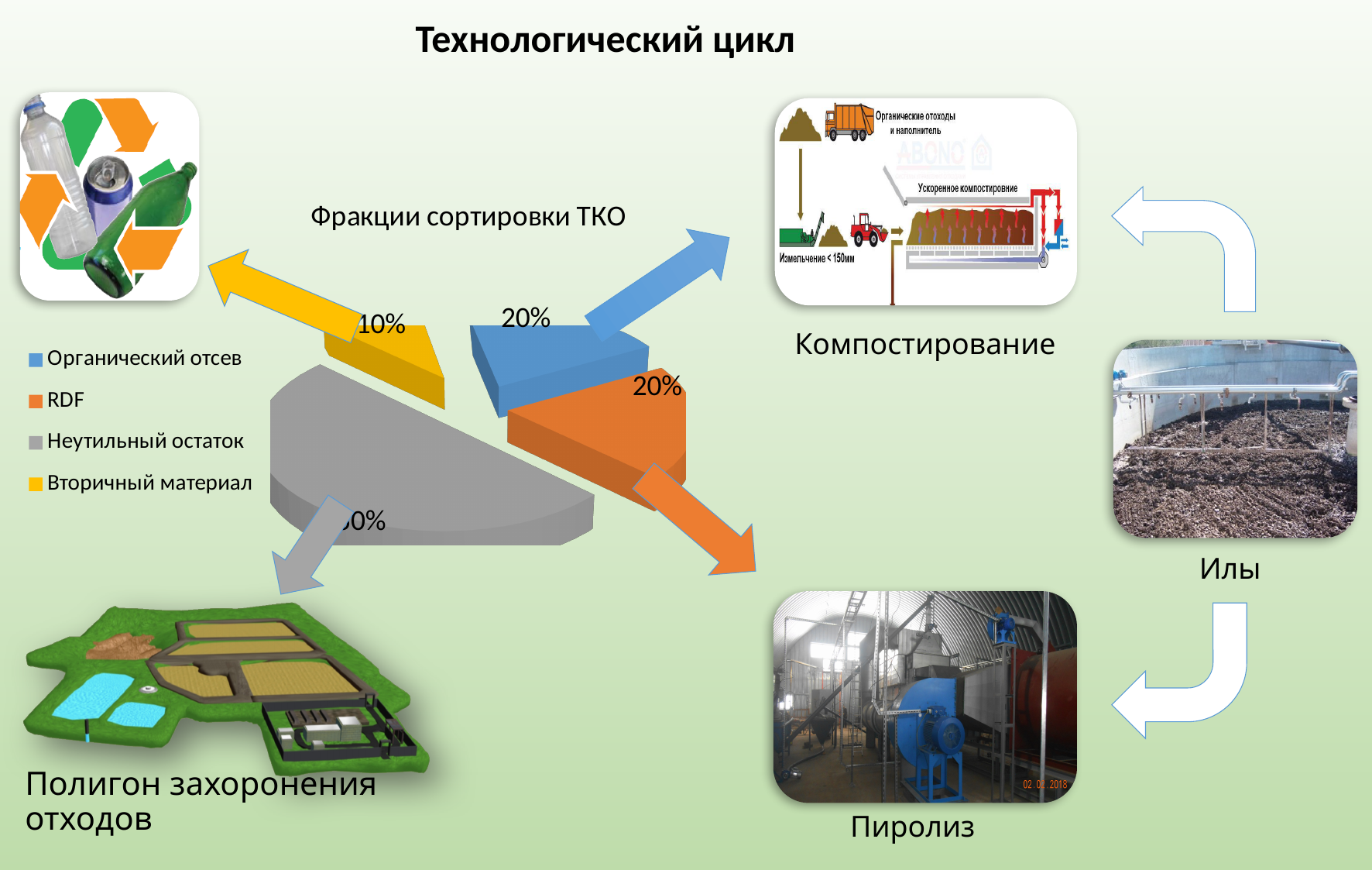
What is the combined share of Органический отсев and RDF? 40% What kind of chart is shown on the slide? pie chart What is the value for Органический отсев in the pie chart? 20% Which category has the largest slice in the pie chart? Неутильный остаток Which is larger in the pie chart: Органический отсев or Вторичный материал? Органический отсев How many categories does the legend of the pie chart list? 4 What colour represents RDF in the pie chart? orange What is the title of the pie chart? Фракции сортировки ТКО What share of the pie does Вторичный материал have? 10% What is the difference between the values for Органический отсев and Вторичный материал? 10% Which category has the smallest slice in the pie chart? Вторичный материал What is the value for RDF in the pie chart? 20%